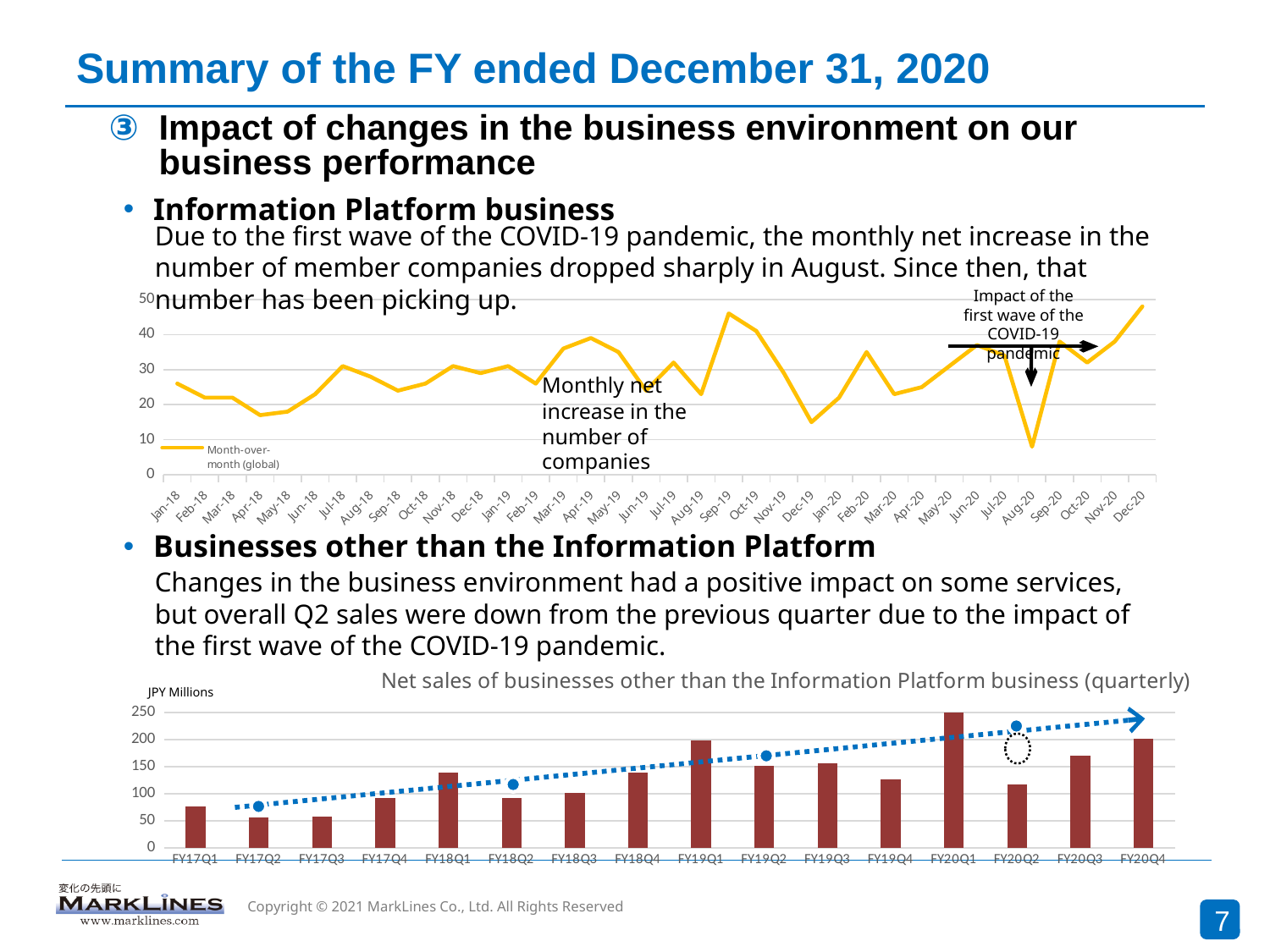
On the bottom chart (Net sales of businesses other than the Information Platform business), which quarter has the highest net sales? FY20Q1 On the bottom chart (Net sales of businesses other than the Information Platform business), is the value for FY20Q2 greater or less than 150? less On the top chart (Monthly net increase in the number of companies), what is the legend entry for the plotted line? Month-over-month (global) What kind of chart is the top chart (Monthly net increase in the number of companies)? Line chart On the top chart (Monthly net increase in the number of companies), is the value for Dec-20 greater or less than 40? greater On the bottom chart (Net sales of businesses other than the Information Platform business), how many quarters are plotted? 16 On the top chart (Monthly net increase in the number of companies), which month has the lowest value? Aug-20 On the bottom chart (Net sales of businesses other than the Information Platform business), is the value for FY20Q1 greater or less than 200? greater On the bottom chart (Net sales of businesses other than the Information Platform business), which is larger, FY20Q1 or FY20Q2? FY20Q1 On the bottom chart, what unit is shown for net sales? JPY Millions What kind of chart is the bottom chart (Net sales of businesses other than the Information Platform business)? Bar chart